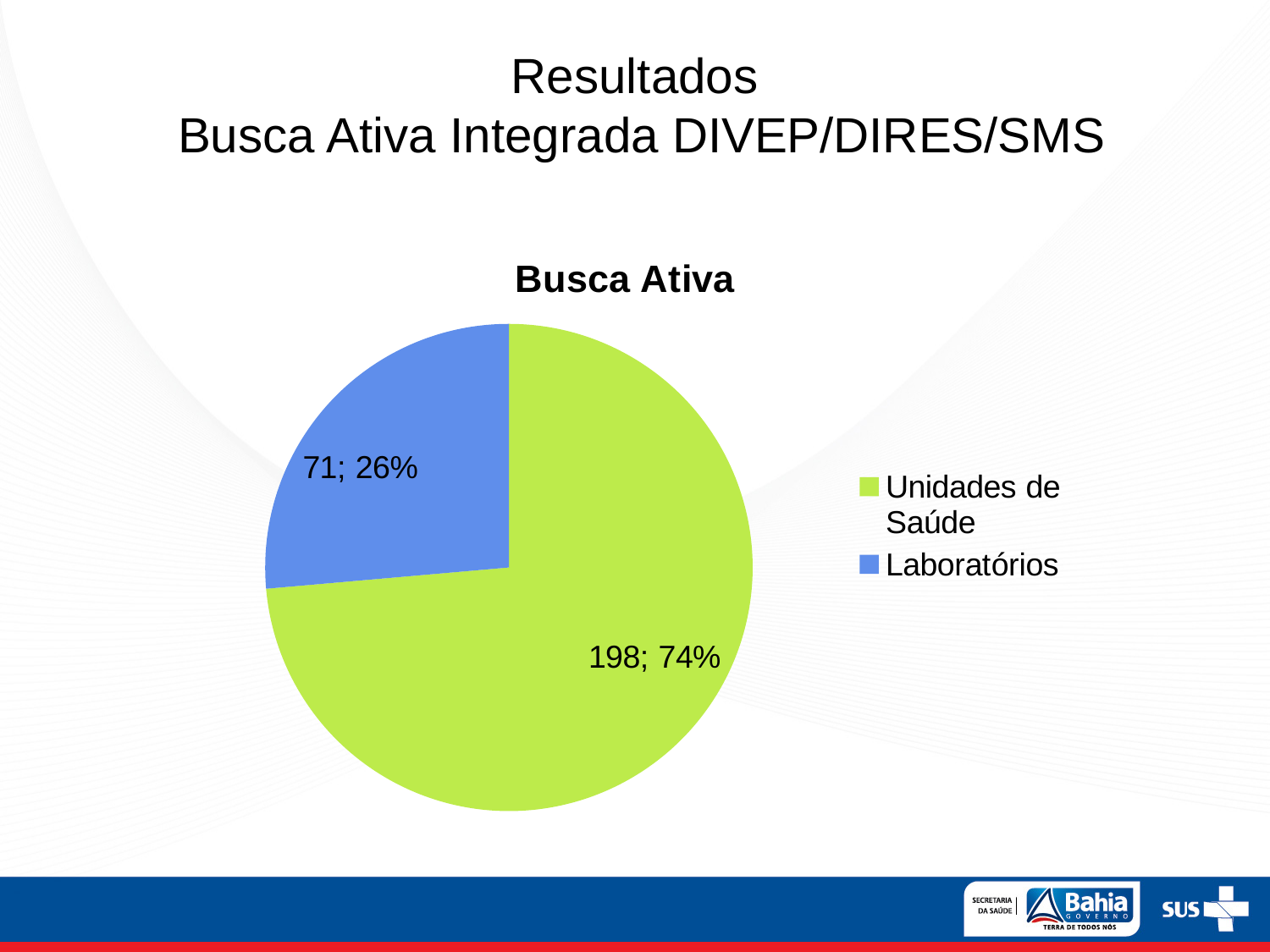
What share of the pie does Unidades de Saúde represent? 74% What is the value for Laboratórios? 71 What is the total of the two slices in the pie chart? 269 Which category has the largest slice? Unidades de Saúde What kind of chart is shown on the slide? pie chart Which is larger, the value for Laboratórios or the value for Unidades de Saúde? Unidades de Saúde How many slices does the pie chart have? 2 What is the title of the chart? Busca Ativa What is the value for Unidades de Saúde? 198 Which category has the smallest slice? Laboratórios What is the difference between the values for Unidades de Saúde and Laboratórios? 127 What share of the pie does Laboratórios represent? 26%